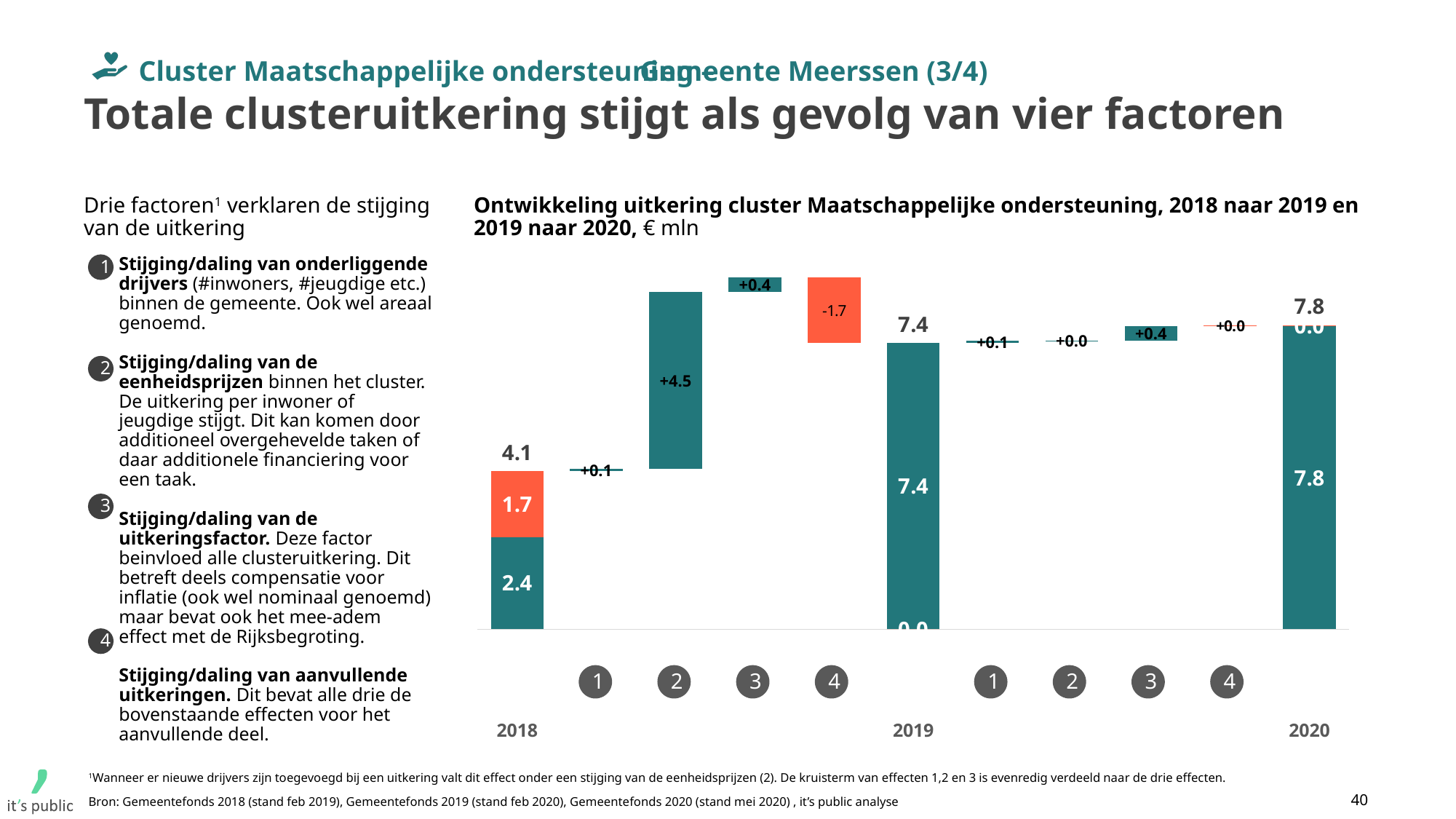
What is the value of factor 3 (uitkeringsfactor) in the step from 2019 to 2020? +0.4 Which year has the higher total uitkering, 2018 or 2019? 2019 What unit is the chart expressed in, according to its title? € mln Which of the four factors has the largest effect in the step from 2018 to 2019? 2 What is the total uitkering shown for 2018? 4.1 What is the value of factor 2 (eenheidsprijzen) in the step from 2018 to 2019? +4.5 What is the value of factor 4 (aanvullende uitkeringen) in the step from 2018 to 2019? -1.7 How many year totals are shown in the chart? 3 What are the two components of the 2018 bar? 2.4 and 1.7 What is the difference between the 2020 total (7.8) and the 2018 total (4.1)? 3.7 What is the total uitkering shown for 2020? 7.8 What is the total uitkering shown for 2019? 7.4